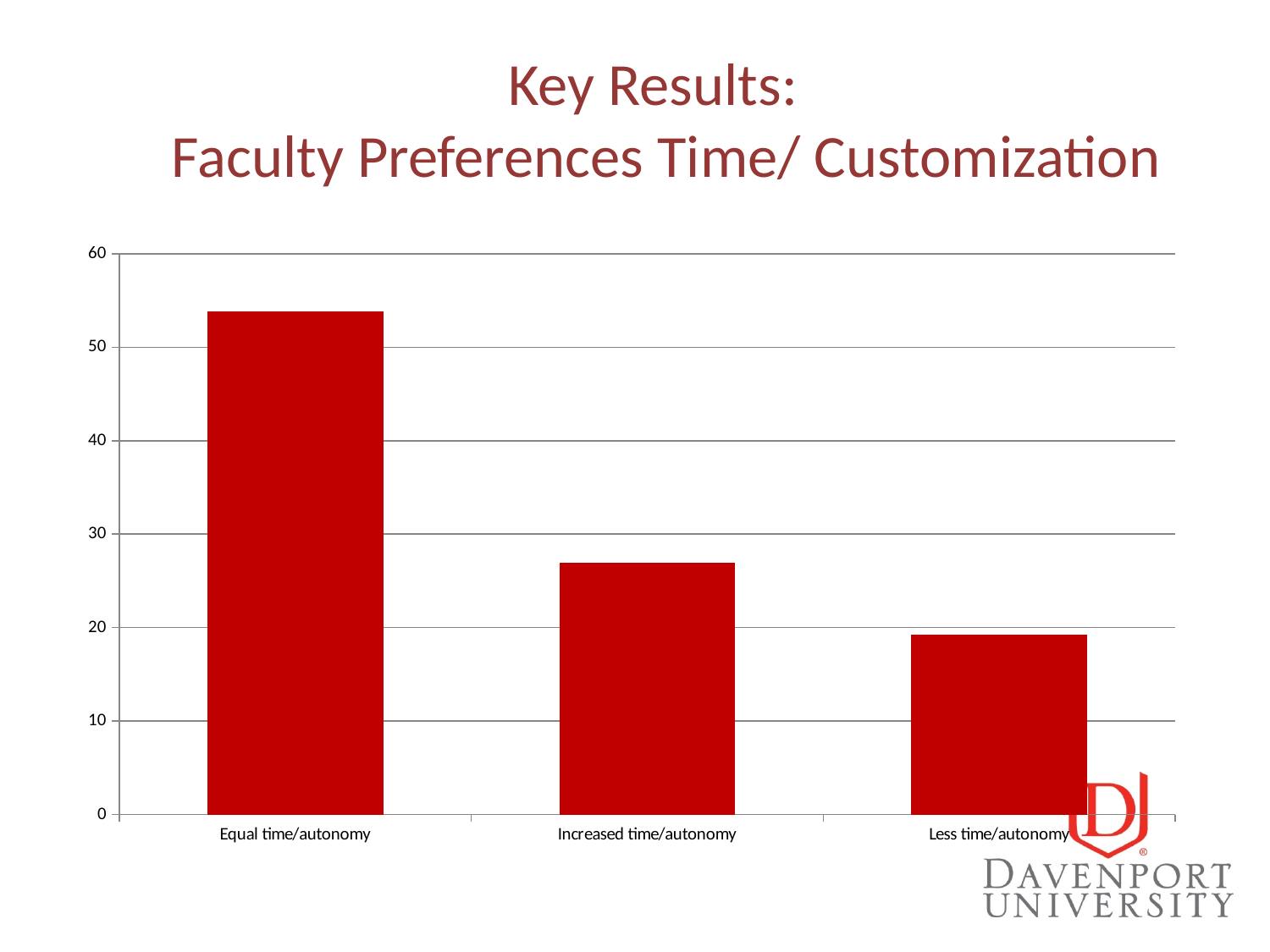
Do the values rise or fall moving from left to right along the x axis? fall Which category has the highest value? Equal time/autonomy Which is larger, the value for Increased time/autonomy or the value for Less time/autonomy? Increased time/autonomy How many categories are shown on the x axis of the chart? 3 What is the title of the slide containing the chart? Key Results: Faculty Preferences Time/ Customization What colour are the bars in the chart? red What kind of chart is shown on the slide? bar chart Is the value for Less time/autonomy greater or less than 20? less Which category has the lowest value? Less time/autonomy Is the value for Equal time/autonomy greater or less than 50? greater Is the value for Increased time/autonomy greater or less than 30? less